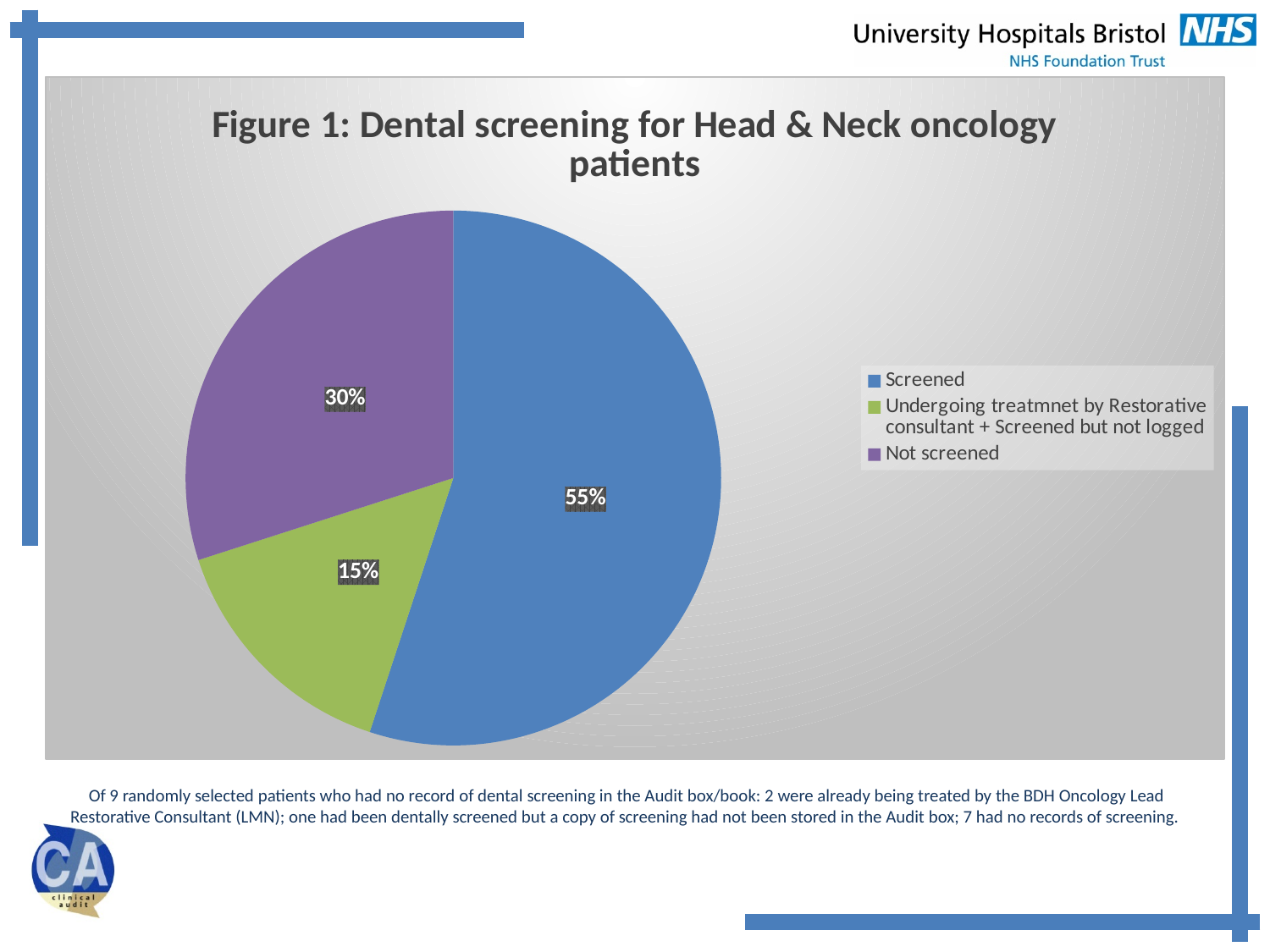
Which category has the smallest share of the pie? Undergoing treatmnet by Restorative consultant + Screened but not logged What is the title of the chart? Figure 1: Dental screening for Head & Neck oncology patients What kind of chart is shown on the slide? pie chart Which category has the largest share of the pie? Screened What percentage is shown for 'Undergoing treatmnet by Restorative consultant + Screened but not logged'? 15% How many slices does the pie chart have? 3 What is the difference in percentage points between Screened and Not screened? 25 Which is larger: the share for Not screened or the share for 'Undergoing treatmnet by Restorative consultant + Screened but not logged'? Not screened How many entries does the legend list? 3 What percentage of patients were Not screened? 30% What colour is the Not screened slice? purple What percentage of patients were Screened? 55%